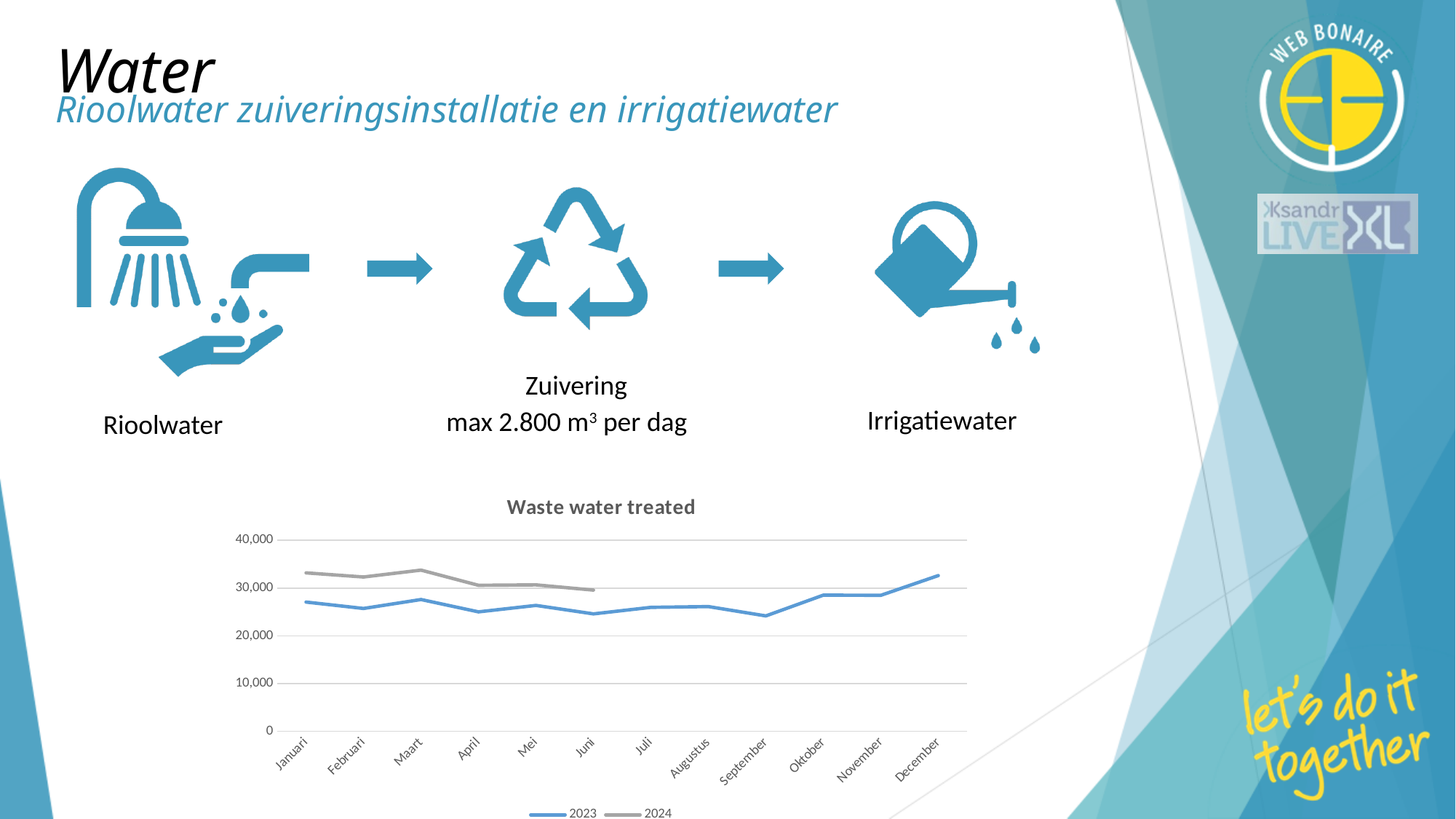
Which colour represents the 2024 series in the chart? gray Is the 2023 value for December greater or less than 30,000? greater Is the 2023 value for September greater or less than 30,000? less Does the 2024 series rise or fall from Januari to Juni? fall How many months are shown on the x axis of the chart? 12 What kind of chart is shown on the slide? line chart How many series does the chart legend list? 2 For how many months does the 2024 series have plotted data? 6 What is the title of the chart? Waste water treated In Maart, which series has the higher value, 2023 or 2024? 2024 In which month does the 2023 series reach its highest value? December Is the 2024 value for Januari greater or less than 30,000? greater